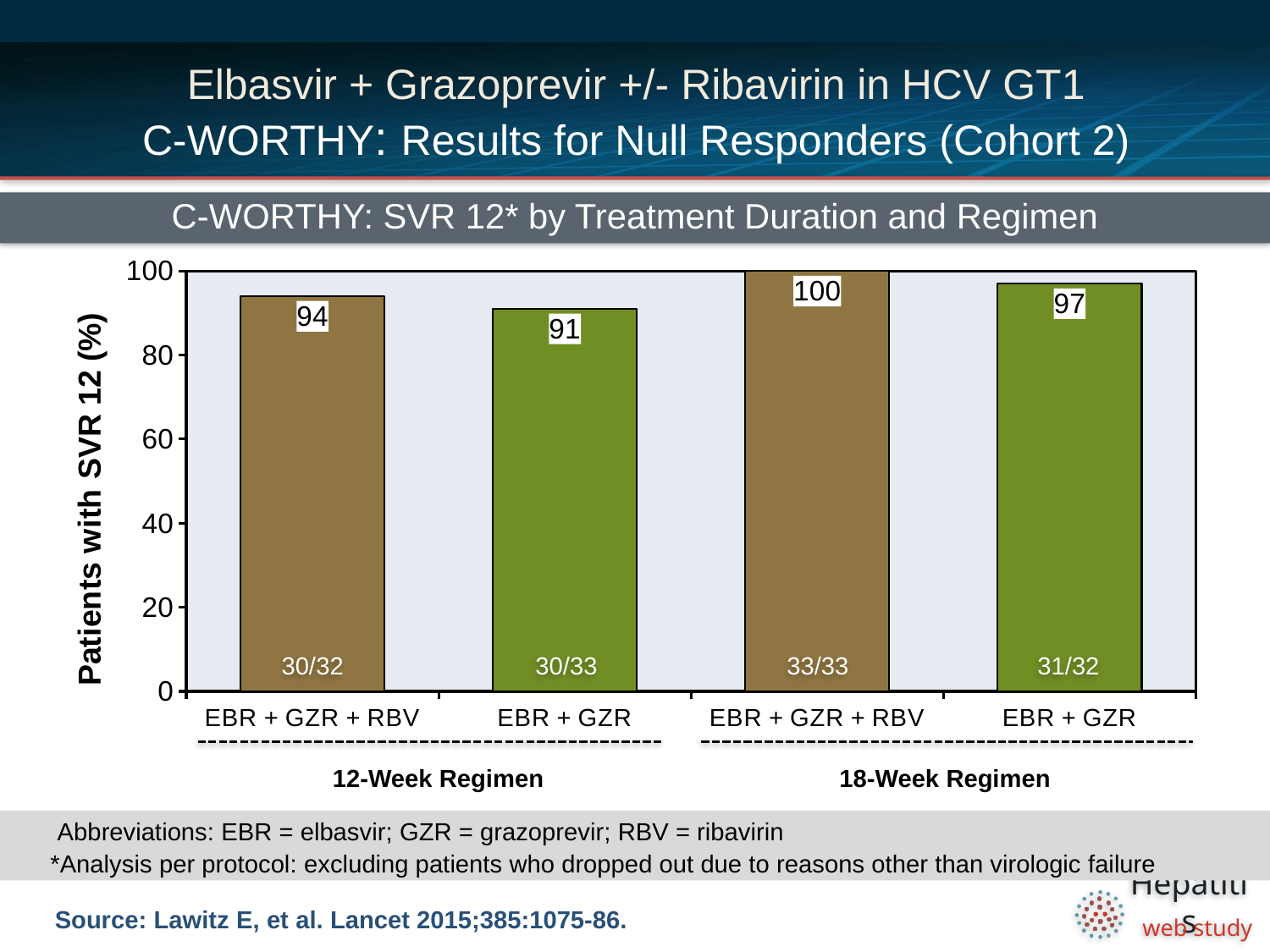
Which bar has the highest SVR 12 rate? EBR + GZR + RBV, 18-Week Regimen What is the title of the chart? C-WORTHY: SVR 12* by Treatment Duration and Regimen How many bars are shown in the chart? 4 What is the SVR 12 rate for EBR + GZR in the 12-Week Regimen? 91 Which has a higher SVR 12 rate: EBR + GZR in the 12-Week Regimen or EBR + GZR in the 18-Week Regimen? EBR + GZR in the 18-Week Regimen How many patients achieved SVR 12 out of the total for EBR + GZR + RBV in the 18-Week Regimen? 33/33 What is the SVR 12 rate for EBR + GZR in the 18-Week Regimen? 97 What kind of chart is shown on the slide? Bar chart What is the difference in SVR 12 rate between EBR + GZR + RBV and EBR + GZR in the 12-Week Regimen? 3 Which bar has the lowest SVR 12 rate? EBR + GZR, 12-Week Regimen What is the label of the y-axis? Patients with SVR 12 (%) What is the SVR 12 rate for EBR + GZR + RBV in the 12-Week Regimen? 94